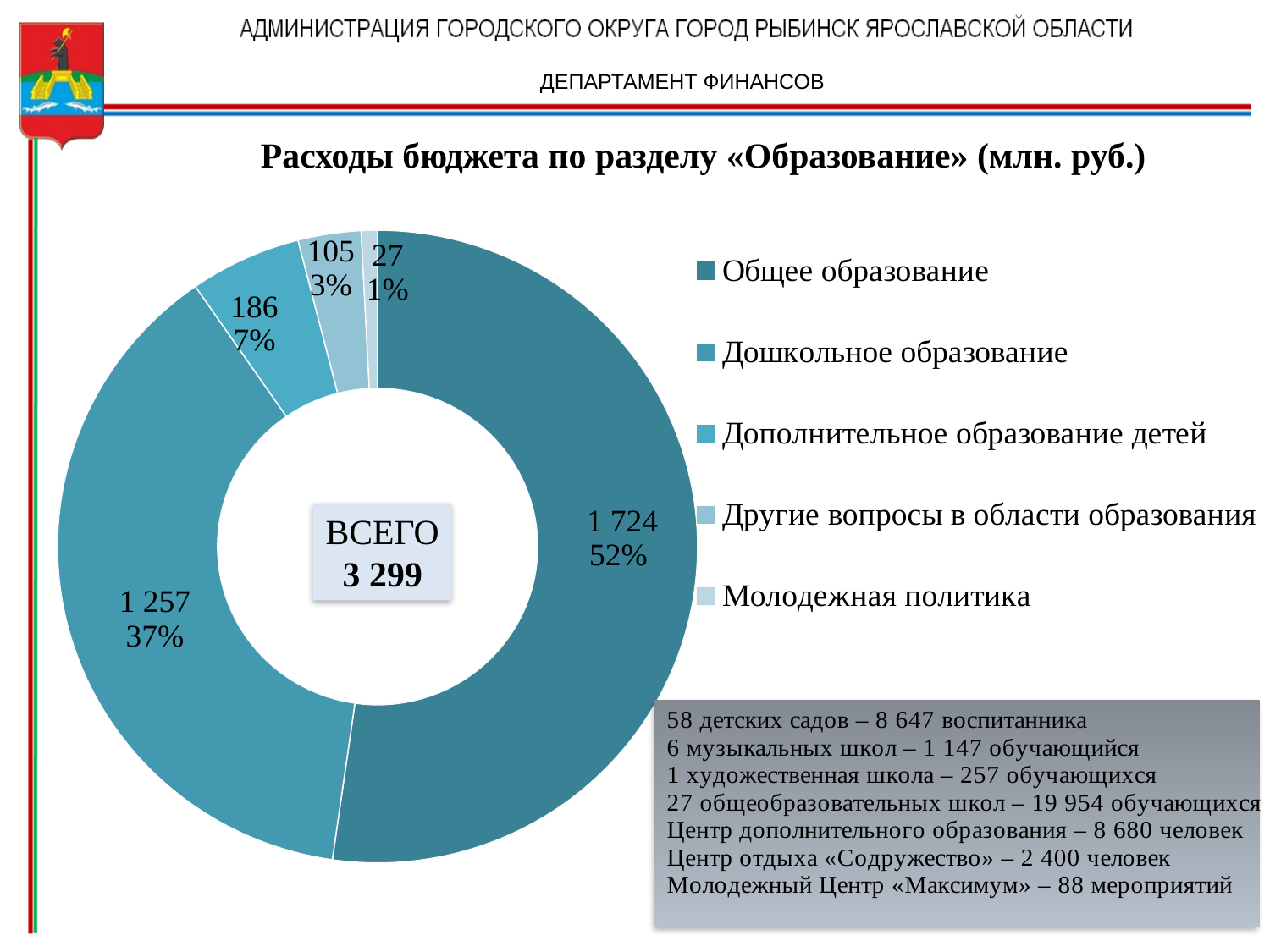
What is the value for Молодежная политика? 27 Which is larger, Дополнительное образование детей or Другие вопросы в области образования? Дополнительное образование детей What is the value for Дошкольное образование? 1 257 What is the value for Дополнительное образование детей? 186 What total (ВСЕГО) is shown in the centre of the chart? 3 299 What share of the total does Дошкольное образование represent? 37% Which category has the smallest slice? Молодежная политика Which category has the largest slice? Общее образование What kind of chart is shown on the slide? Pie (doughnut) chart What is the value for Общее образование? 1 724 How many categories does the chart show? 5 What is the difference between the values for Общее образование and Дошкольное образование? 467